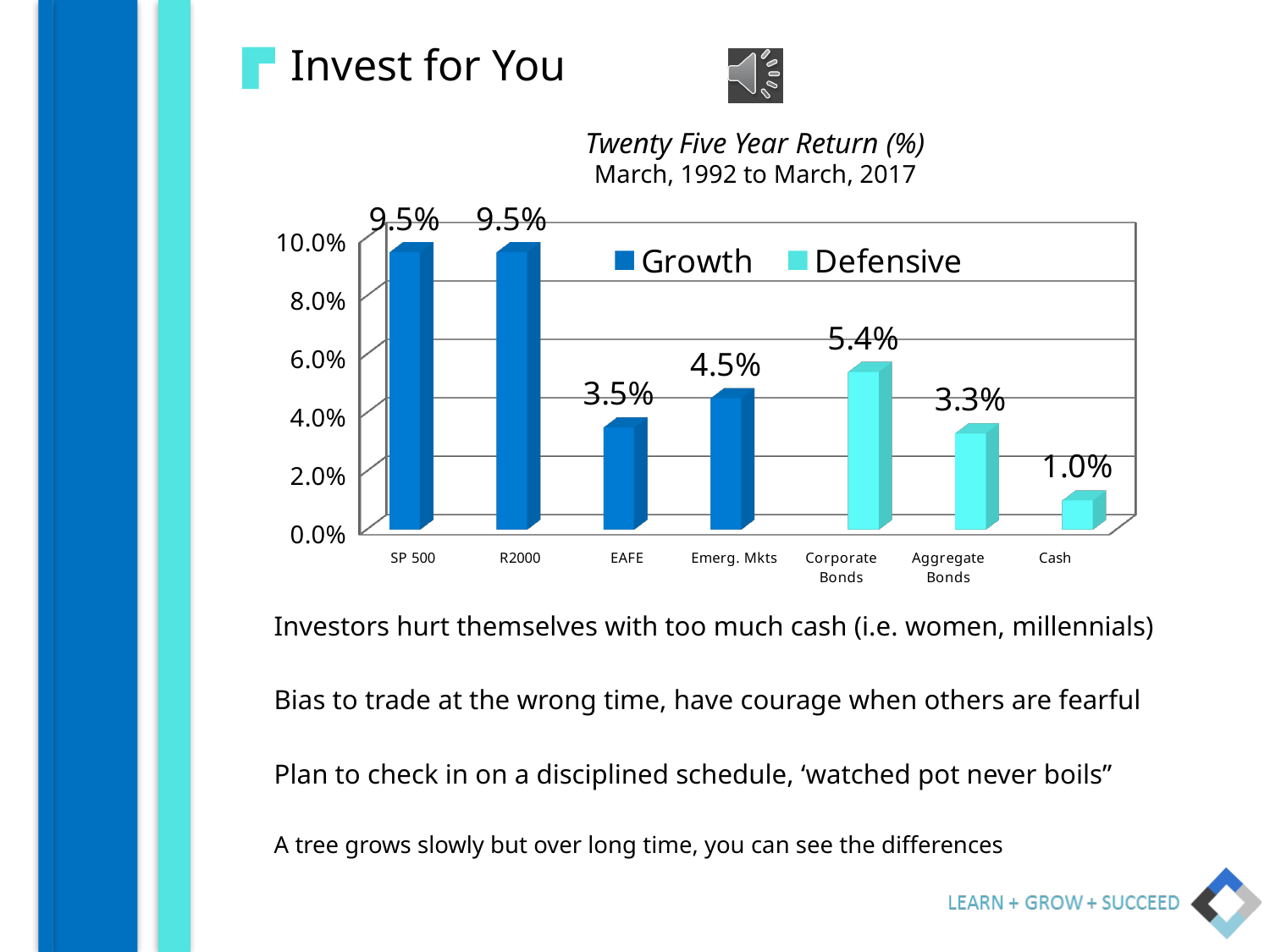
How many series does the chart legend list? 2 Which has a higher return, EAFE or Aggregate Bonds? EAFE What is the twenty five year return for Cash? 1.0% What time period does the chart subtitle give? March, 1992 to March, 2017 What is the twenty five year return for EAFE? 3.5% How many categories are shown on the x axis of the chart? 7 What is the difference between the returns for Corporate Bonds and Aggregate Bonds? 2.1% What is the difference between the returns for SP 500 and Emerg. Mkts? 5.0% Which category has the lowest twenty five year return? Cash Which has a higher return, Emerg. Mkts or Corporate Bonds? Corporate Bonds What kind of chart is shown on the slide? Bar chart What is the twenty five year return for Corporate Bonds? 5.4%